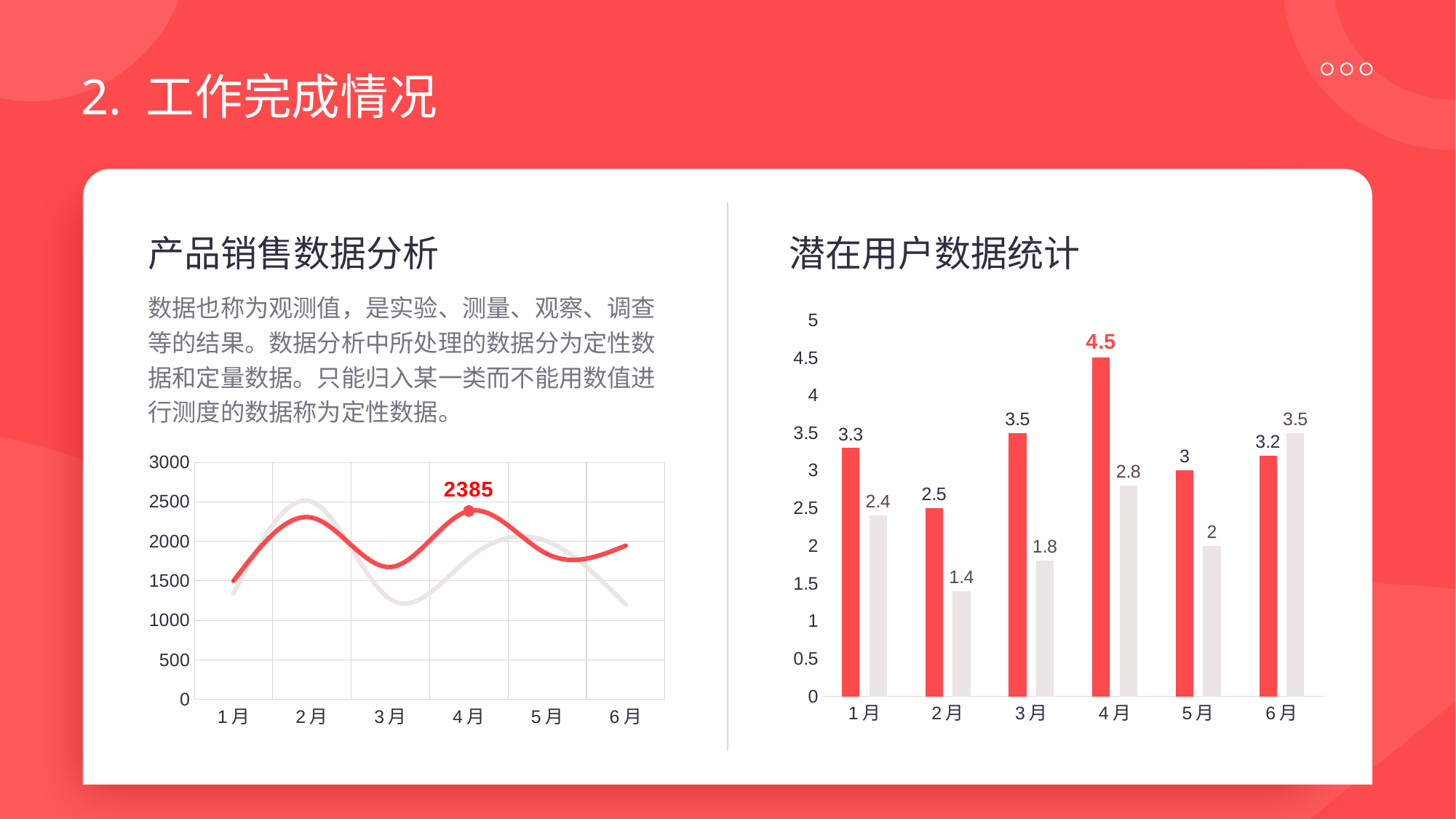
In the 潜在用户数据统计 chart, what is the value of the red bar for 4月? 4.5 In the 潜在用户数据统计 chart, which is larger for 6月, the red bar or the grey bar? the grey bar In the 潜在用户数据统计 chart, which month has the highest red bar? 4月 In the 潜在用户数据统计 chart, what is the value of the grey bar for 6月? 3.5 In the 潜在用户数据统计 chart, what is the value of the grey bar for 2月? 1.4 What kind of chart is the 潜在用户数据统计 chart? bar chart In the 潜在用户数据统计 chart, which month has the lowest grey bar? 2月 In the 潜在用户数据统计 chart, what is the difference between the red bar and the grey bar for 4月? 1.7 In the 产品销售数据分析 chart, is the value of the red line at 1月 greater or less than 2000? less In the 产品销售数据分析 chart, what value is labelled on the red line at 4月? 2385 How many months are shown on the x axis of the 潜在用户数据统计 chart? 6 What kind of chart is the 产品销售数据分析 chart? line chart